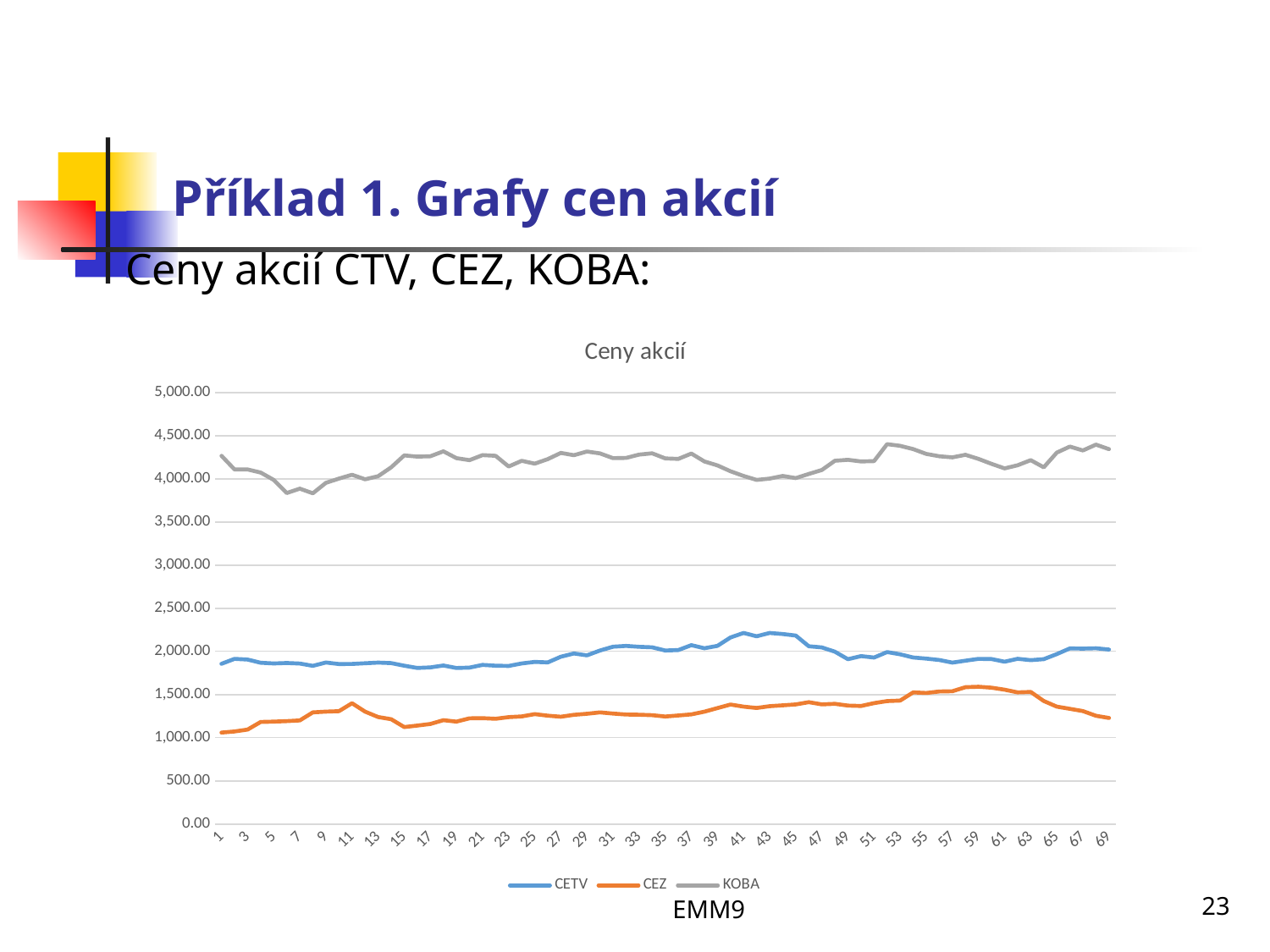
Which series has the lowest values across the whole chart? CEZ Is the value for CEZ at point 59 greater or less than 1,500.00? greater Does the CEZ line rise or fall between point 1 and point 11? rise Which series has the highest values across the whole chart? KOBA At point 1, which series has the larger value, CETV or CEZ? CETV What kind of chart is shown on the slide? line chart Is the value for KOBA at point 1 greater or less than 4,000.00? greater Is the value for KOBA at point 7 greater or less than 4,000.00? less What is the title of the chart? Ceny akcií How many series does the legend of the chart list? 3